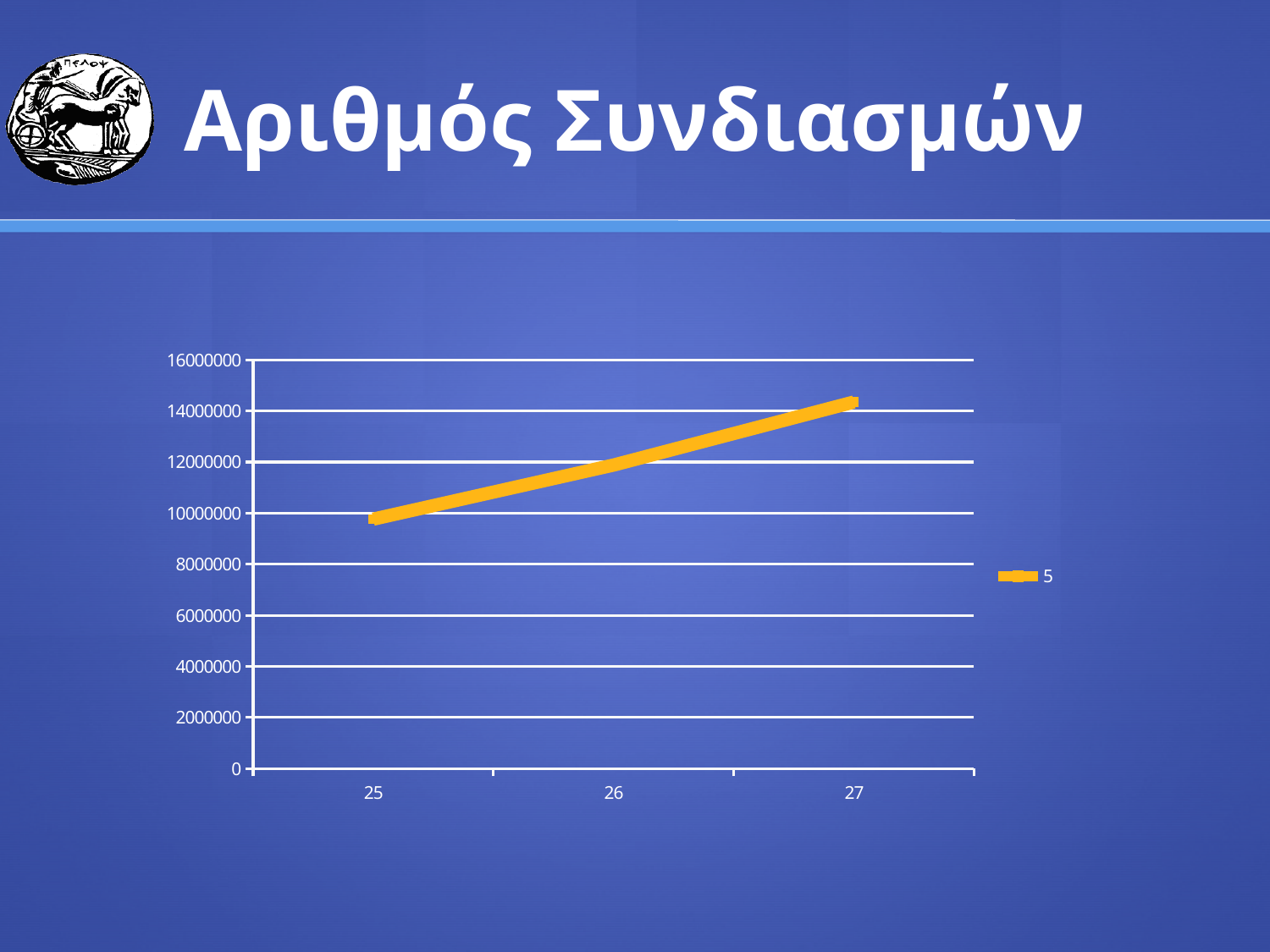
Which x-axis category has the lowest value? 25 Which x-axis category has the highest value? 27 Which has the larger value, 25 or 27? 27 Is the value at 27 greater or less than 14000000? greater Do the values rise or fall as the x axis goes from 25 to 27? rise How many series does the legend list? 1 What kind of chart is shown on the slide? line chart What is the name of the series shown in the legend? 5 How many data points are plotted along the x axis? 3 What is the title of the slide containing the chart? Αριθμός Συνδιασμών Is the value at 25 greater or less than 10000000? less